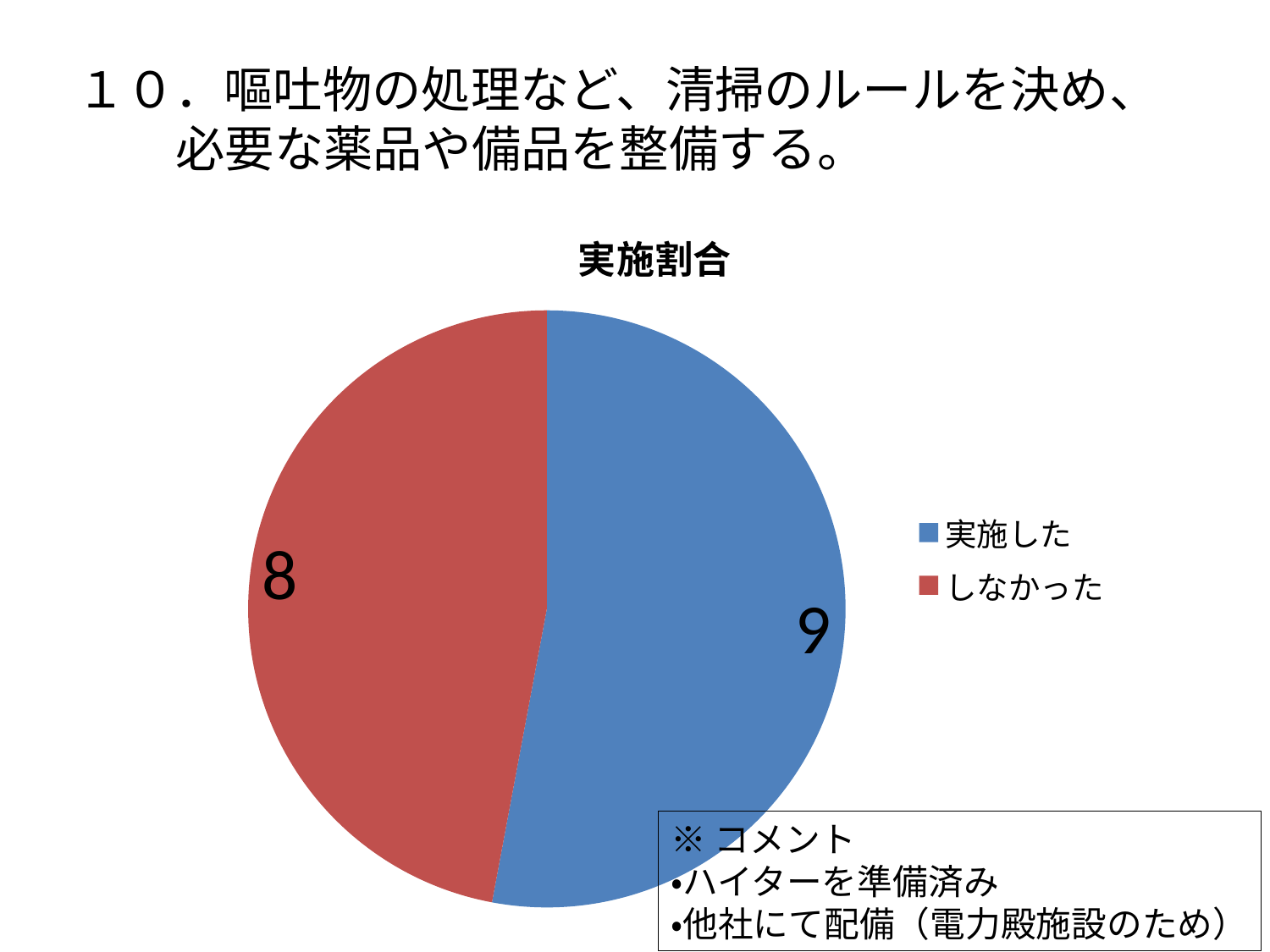
Which is larger, the value for 実施した or the value for しなかった? 実施した What is the value for 実施した in the pie chart? 9 What kind of chart is shown on the slide? Pie chart Which category has the largest slice in the pie chart? 実施した What is the title of the chart? 実施割合 How many entries does the legend list? 2 What colour is the slice for しなかった? Red Which category has the smallest slice in the pie chart? しなかった What is the difference between the values for 実施した and しなかった? 1 What is the total of the two slices in the pie chart? 17 What is the value for しなかった in the pie chart? 8 How many categories does the pie chart show? 2